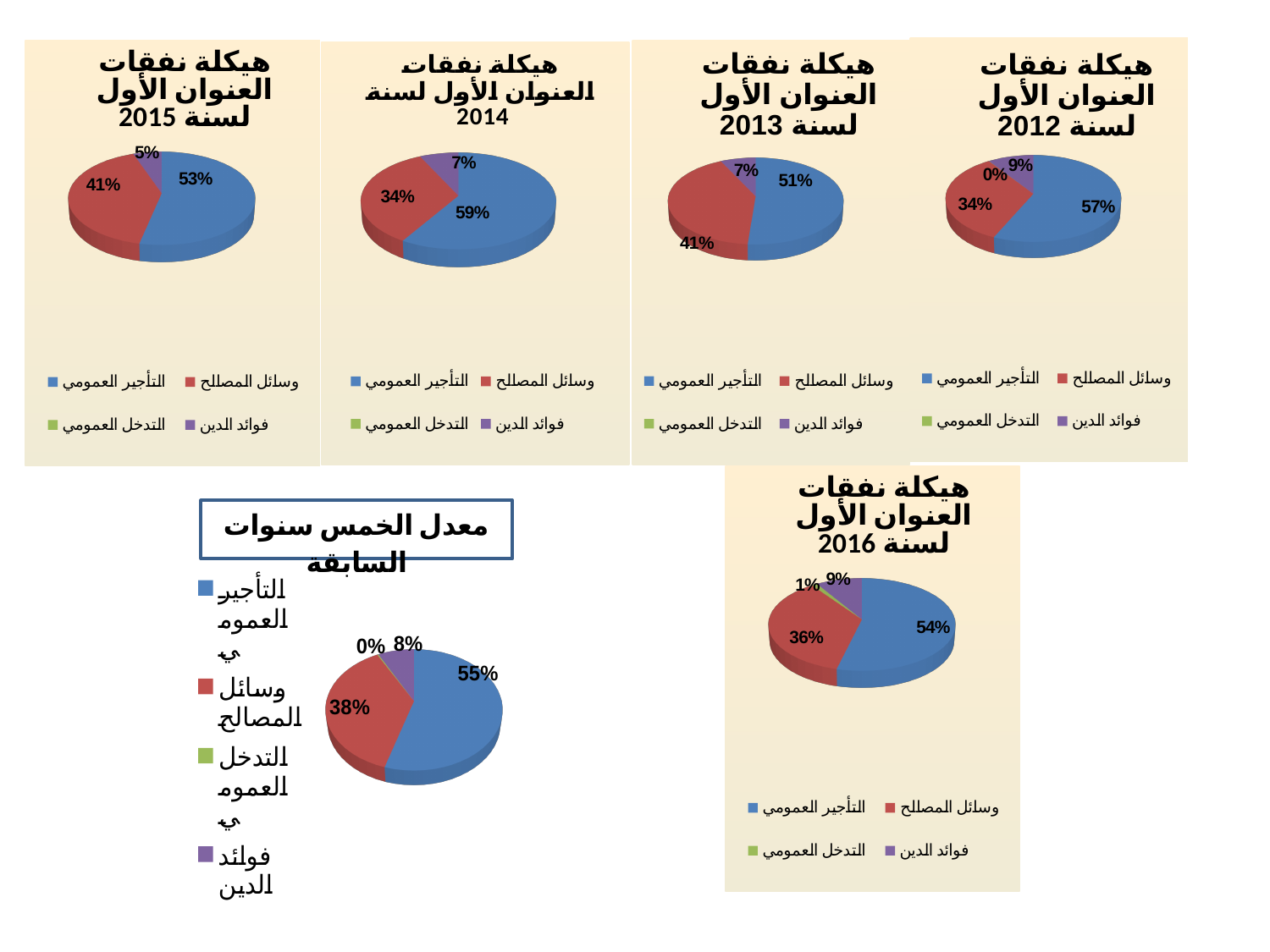
In the chart titled 'هيكلة نفقات العنوان الأول لسنة 2013', which category has the largest share? التأجير العمومي In the chart titled 'هيكلة نفقات العنوان الأول لسنة 2016', what share does التأجير العمومي have? 54% In the chart titled 'هيكلة نفقات العنوان الأول لسنة 2015', which labelled category has the smallest share? فوائد الدين In the chart titled 'هيكلة نفقات العنوان الأول لسنة 2014', what is the difference between the shares of التأجير العمومي and وسائل المصالح? 25% In the chart titled 'هيكلة نفقات العنوان الأول لسنة 2016', which is larger: the share of وسائل المصالح or the share of فوائد الدين? وسائل المصالح In the chart titled 'هيكلة نفقات العنوان الأول لسنة 2016', what share does التدخل العمومي have? 1% How many series does the legend of the chart titled 'هيكلة نفقات العنوان الأول لسنة 2016' list? 4 How many pie charts are shown on the slide? 6 In the chart titled 'هيكلة نفقات العنوان الأول لسنة 2012', what share does فوائد الدين have? 9% In the chart titled 'هيكلة نفقات العنوان الأول لسنة 2014', what share does وسائل المصالح have? 34% In the chart titled 'معدل الخمس سنوات السابقة', what share does وسائل المصالح have? 38% What kind of chart is used for 'هيكلة نفقات العنوان الأول لسنة 2012'? Pie chart